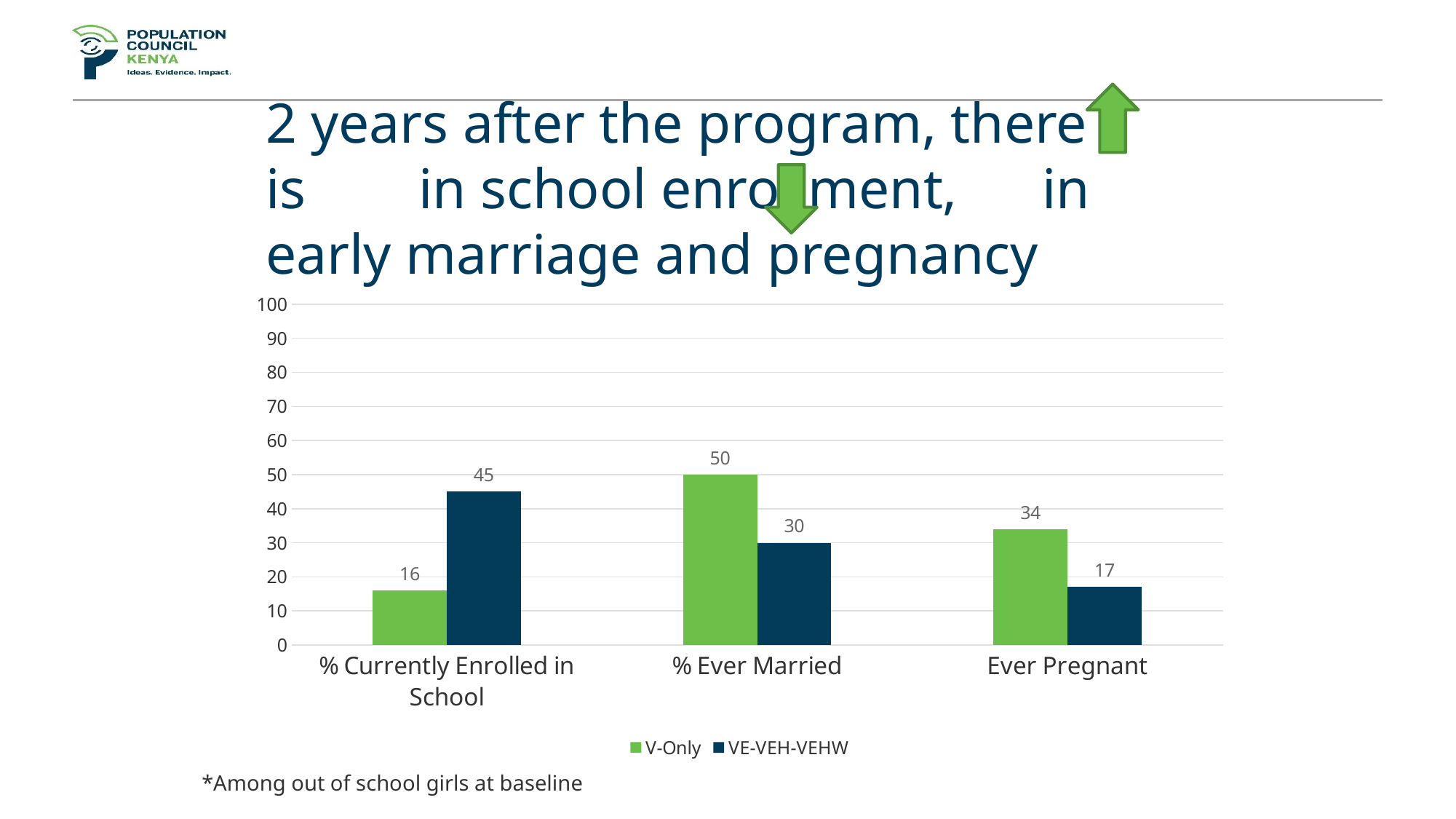
Which category has the lowest VE-VEH-VEHW value? Ever Pregnant What is the value for VE-VEH-VEHW in the % Ever Married category? 30 How many categories are shown on the x axis? 3 What is the difference between the VE-VEH-VEHW and V-Only values for % Currently Enrolled in School? 29 Which category has the highest V-Only value? % Ever Married Which is larger for Ever Pregnant: V-Only or VE-VEH-VEHW? V-Only What is the value for VE-VEH-VEHW in the % Currently Enrolled in School category? 45 What kind of chart is shown on the slide? Bar chart What is the value for V-Only in the % Currently Enrolled in School category? 16 What is the value for V-Only in the Ever Pregnant category? 34 What is the difference between the V-Only and VE-VEH-VEHW values for % Ever Married? 20 How many series does the legend list? 2